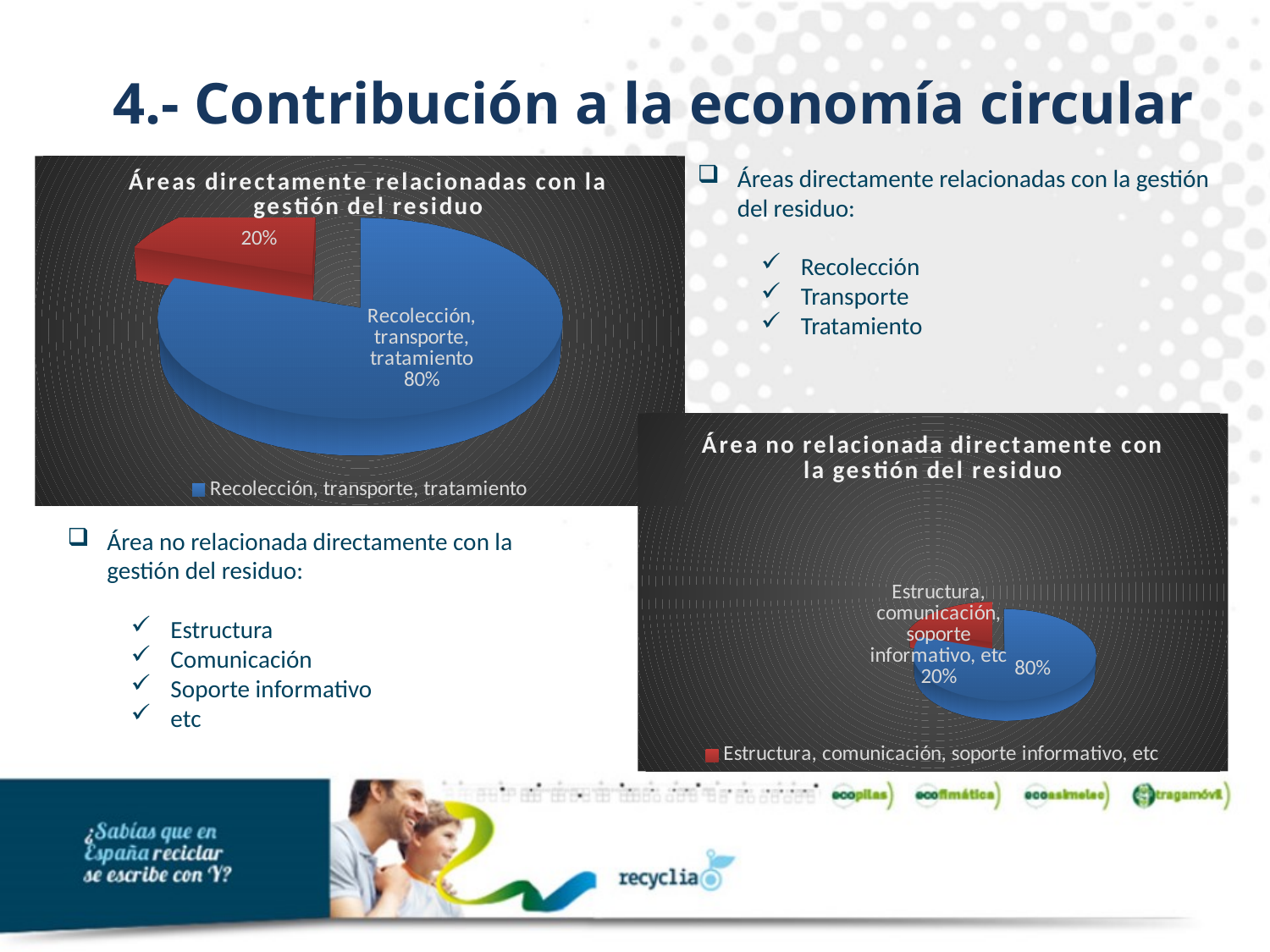
In the chart titled "Áreas directamente relacionadas con la gestión del residuo", which slice is the largest? Recolección, transporte, tratamiento In the chart titled "Área no relacionada directamente con la gestión del residuo", what percentage is shown on the blue slice? 80% How many slices does the chart titled "Áreas directamente relacionadas con la gestión del residuo" have? 2 What colour is the slice labelled "Estructura, comunicación, soporte informativo, etc" in the chart titled "Área no relacionada directamente con la gestión del residuo"? Red What entry does the legend of the chart titled "Áreas directamente relacionadas con la gestión del residuo" list? Recolección, transporte, tratamiento What kind of chart is the one titled "Área no relacionada directamente con la gestión del residuo"? Pie chart In the chart titled "Áreas directamente relacionadas con la gestión del residuo", what share does the slice labelled "Recolección, transporte, tratamiento" have? 80% What kind of chart is the one titled "Áreas directamente relacionadas con la gestión del residuo"? Pie chart In the chart titled "Áreas directamente relacionadas con la gestión del residuo", what is the difference in percentage points between the two slices? 60 In the chart titled "Áreas directamente relacionadas con la gestión del residuo", what percentage is shown on the red slice? 20% In the chart titled "Área no relacionada directamente con la gestión del residuo", what share does the slice labelled "Estructura, comunicación, soporte informativo, etc" have? 20% In the chart titled "Área no relacionada directamente con la gestión del residuo", is the slice labelled "Estructura, comunicación, soporte informativo, etc" larger or smaller than the blue slice? Smaller